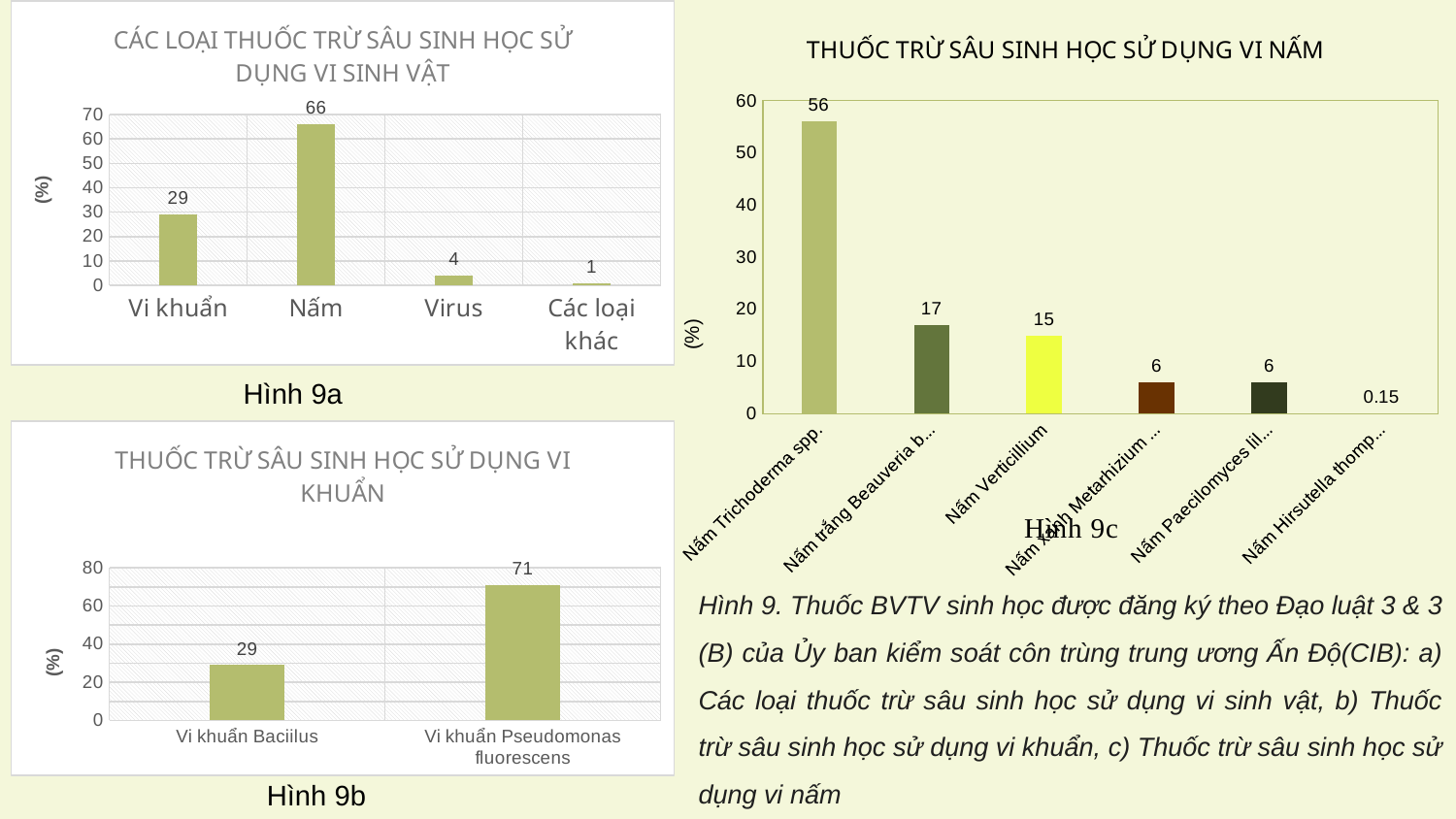
What type of chart is 'Hình 9b' (bottom left)? Bar chart In the chart 'Hình 9b' (bottom left), what is the value for Vi khuẩn Pseudomonas fluorescens? 71 In the chart 'Hình 9c' (right), what is the value for Nấm Verticillium? 15 What is the title of the chart on the right (Hình 9c)? THUỐC TRỪ SÂU SINH HỌC SỬ DỤNG VI NẤM How many categories are shown in the chart 'Hình 9a' (top left)? 4 In the chart 'Hình 9c' (right), which category has the highest value? Nấm Trichoderma spp. How many bars are shown in the chart 'Hình 9c' (right)? 6 In the chart 'Hình 9a' (top left), what is the value for Nấm? 66 In the chart 'Hình 9b' (bottom left), which of the two bars is larger, Vi khuẩn Baciilus or Vi khuẩn Pseudomonas fluorescens? Vi khuẩn Pseudomonas fluorescens In the chart 'Hình 9a' (top left), which category has the lowest value? Các loại khác In the chart 'Hình 9a' (top left), what is the difference between the values for Nấm and Vi khuẩn? 37 In the chart 'Hình 9c' (right), what is the value for Nấm Trichoderma spp.? 56